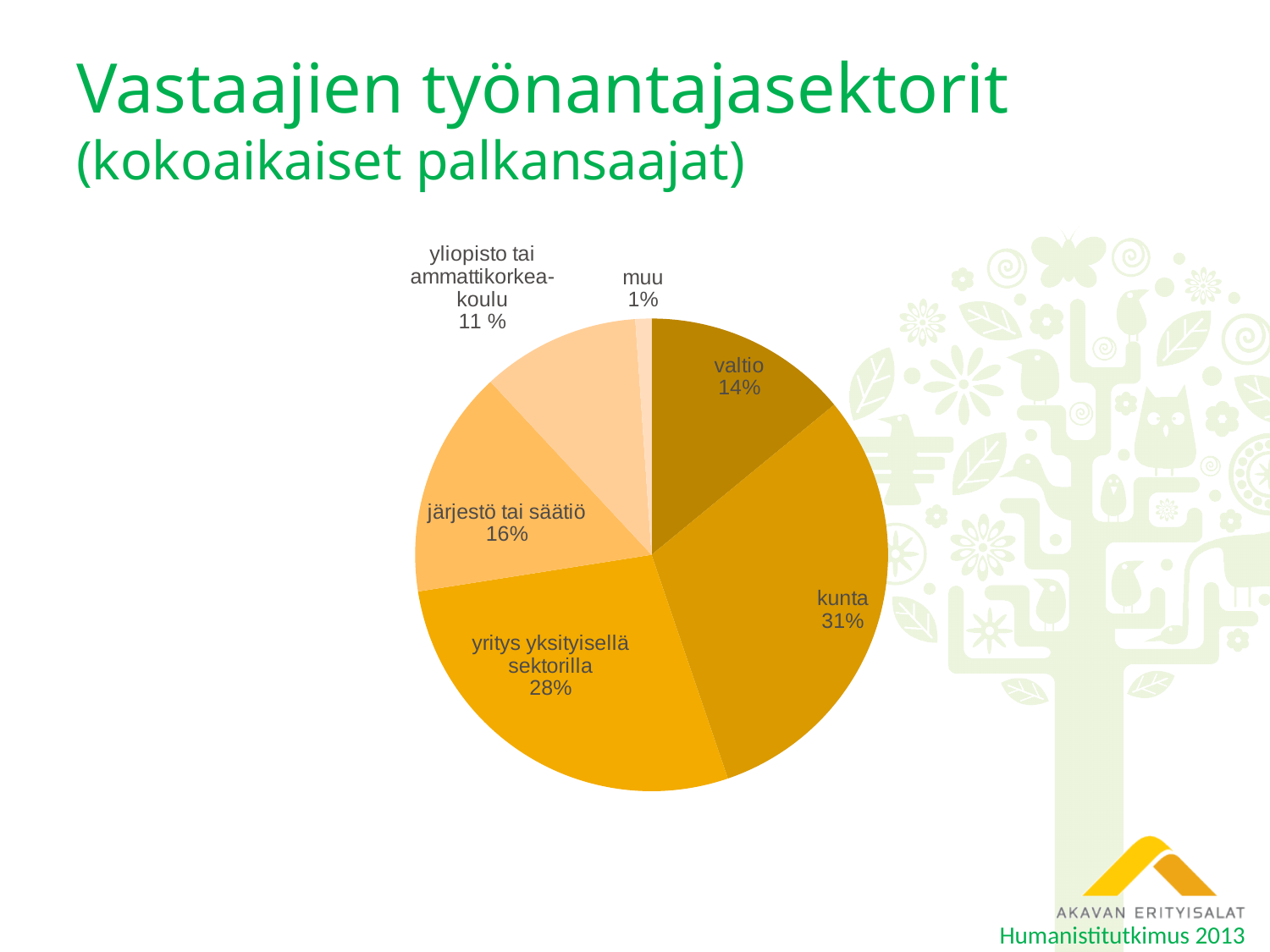
Which employer sector has the largest share of respondents? kunta What share of respondents work for valtio? 14% What share of respondents work for yritys yksityisellä sektorilla? 28% Which employer sector has the smallest share of respondents? muu What is the difference in percentage points between kunta and yritys yksityisellä sektorilla? 3 percentage points Which is larger, the share for järjestö tai säätiö or the share for valtio? järjestö tai säätiö What share of respondents work for yliopisto tai ammattikorkeakoulu? 11 % What kind of chart is shown on the slide? pie chart What share of respondents work for kunta? 31% How many slices does the pie chart have? 6 What share of respondents fall under muu? 1% What share of respondents work for järjestö tai säätiö? 16%